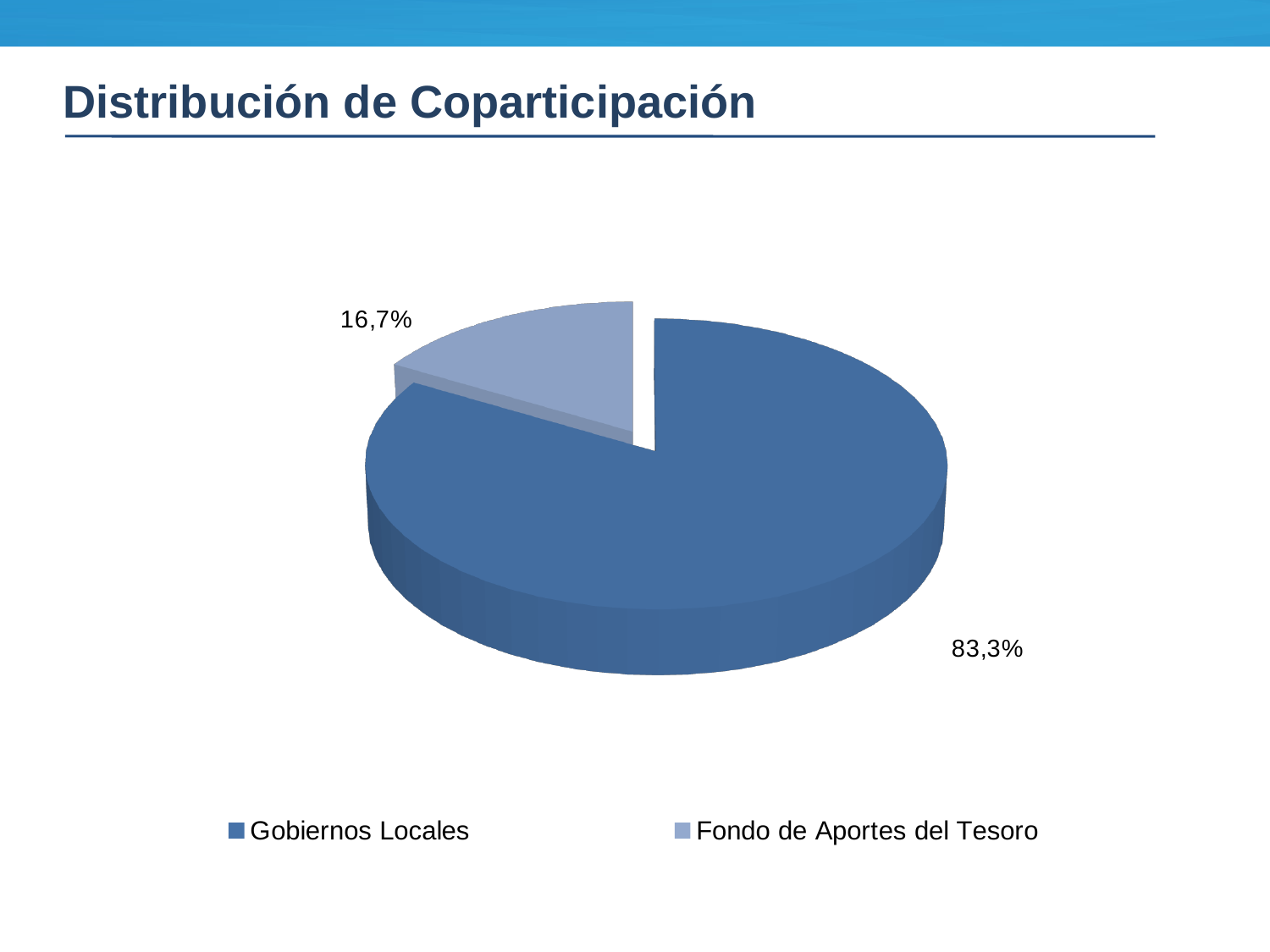
What is the title of the slide containing the chart? Distribución de Coparticipación What is the difference in percentage points between Gobiernos Locales and Fondo de Aportes del Tesoro? 66,6 Which legend entry is shown in the lighter blue colour? Fondo de Aportes del Tesoro How many entries does the legend list? 2 Which category has the largest slice of the pie? Gobiernos Locales What kind of chart is shown on the slide? Pie chart What share of the pie does Fondo de Aportes del Tesoro have? 16,7% How many slices does the pie chart have? 2 Which is larger, the share for Gobiernos Locales or the share for Fondo de Aportes del Tesoro? Gobiernos Locales What share of the pie does Gobiernos Locales have? 83,3% Which category has the smallest slice of the pie? Fondo de Aportes del Tesoro